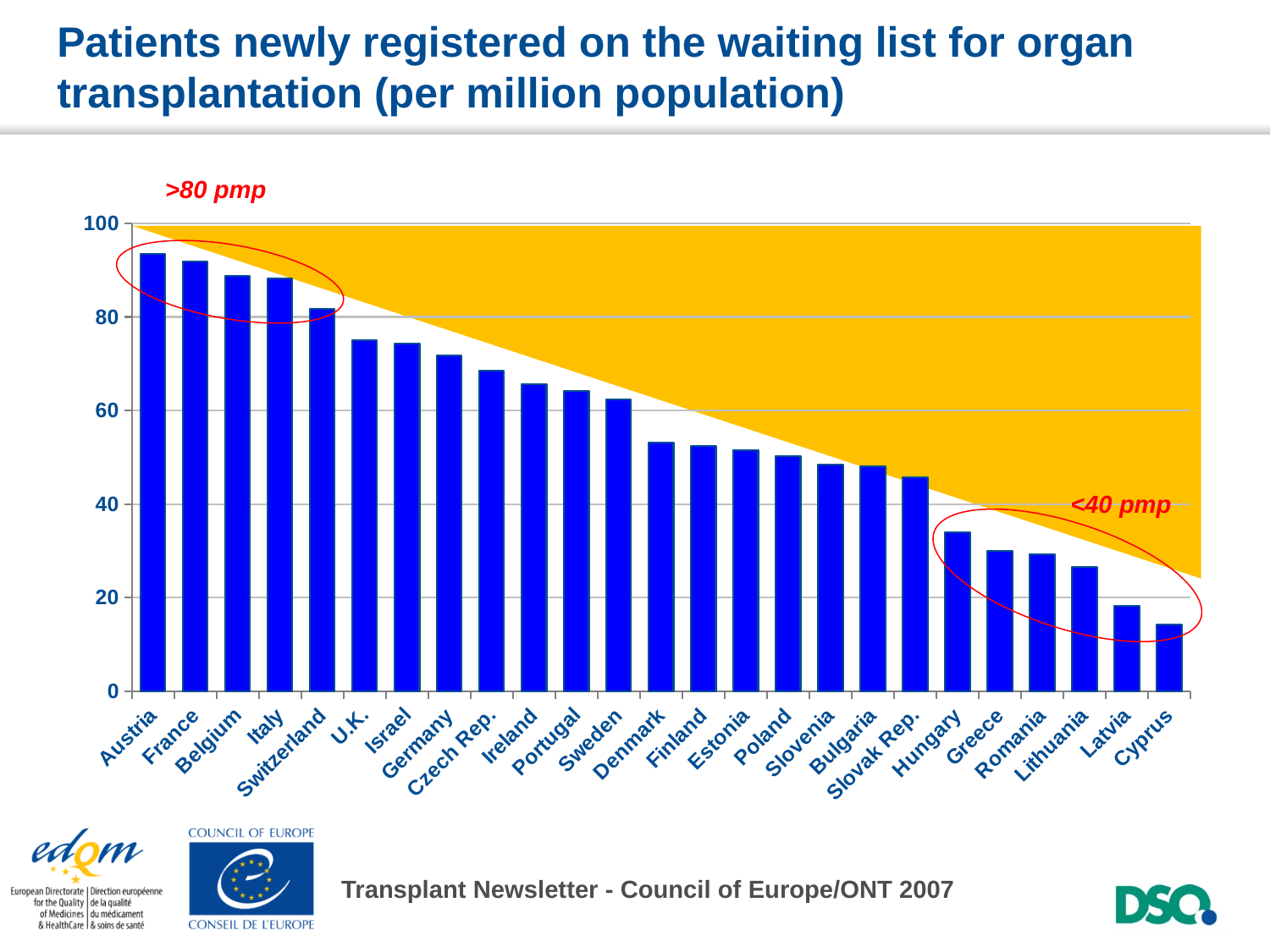
Is the value for Slovak Rep. greater or less than 40? greater Is the value for Latvia greater or less than 20? less Which country has the highest number of patients newly registered on the waiting list per million population? Austria Do the values rise or fall moving from left to right along the x axis? fall What kind of chart is shown on the slide? bar chart Which has a higher value, Germany or Greece? Germany How many countries are shown on the x axis of the chart? 25 Is the value for Hungary greater or less than 40? less What label is written in red above the circled group of the highest bars? >80 pmp Which country has the lowest number of patients newly registered on the waiting list per million population? Cyprus